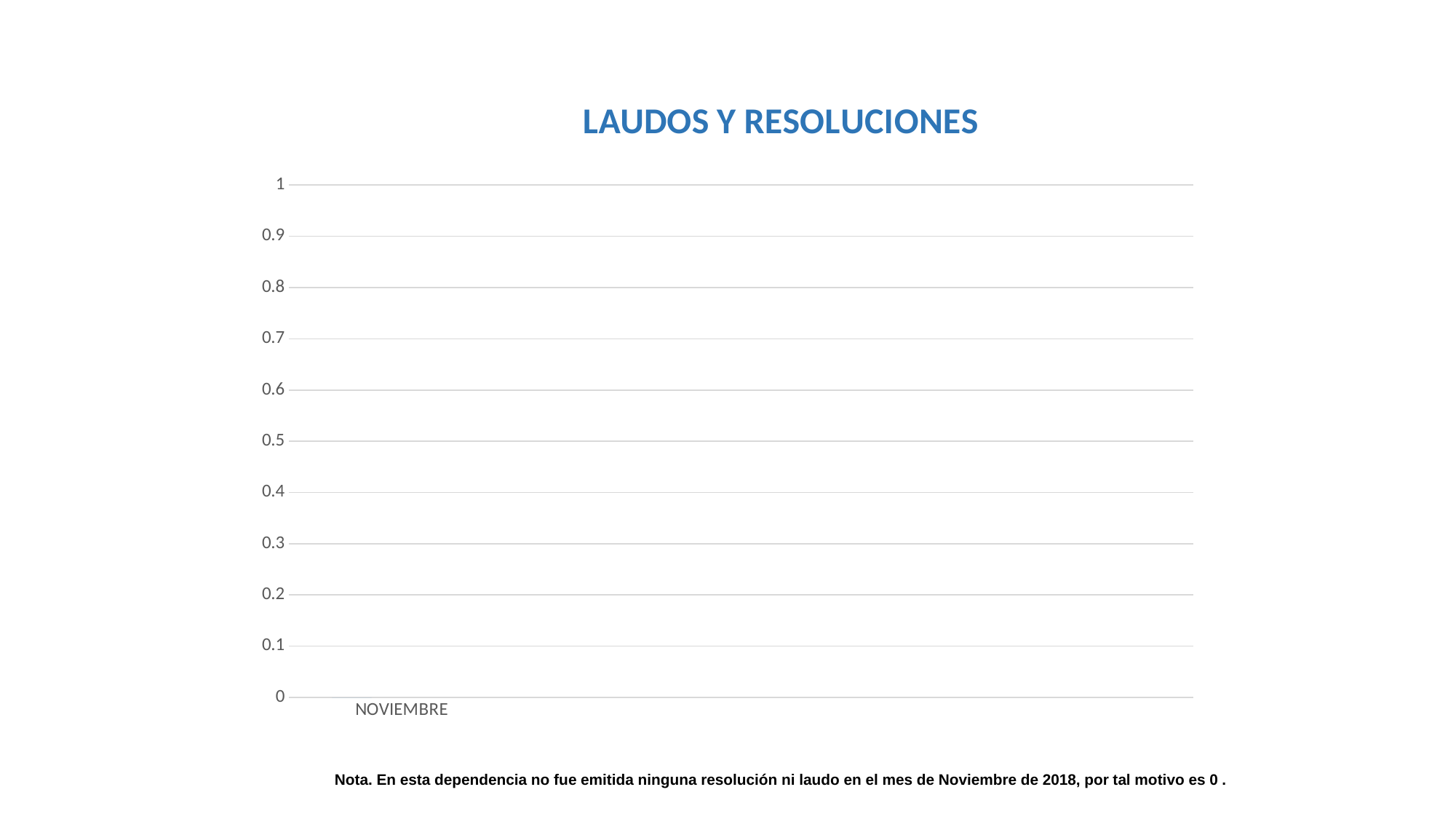
What is the highest value shown on the y axis of the chart? 1 What category label appears on the x axis of the chart? NOVIEMBRE How many categories are shown on the x axis of the chart? 1 Is the value for NOVIEMBRE greater or less than 0.1? less What is the title of the chart? LAUDOS Y RESOLUCIONES Is the value for NOVIEMBRE greater or less than 0.5? less What kind of chart is shown on the slide? bar chart What is the value plotted for NOVIEMBRE? 0